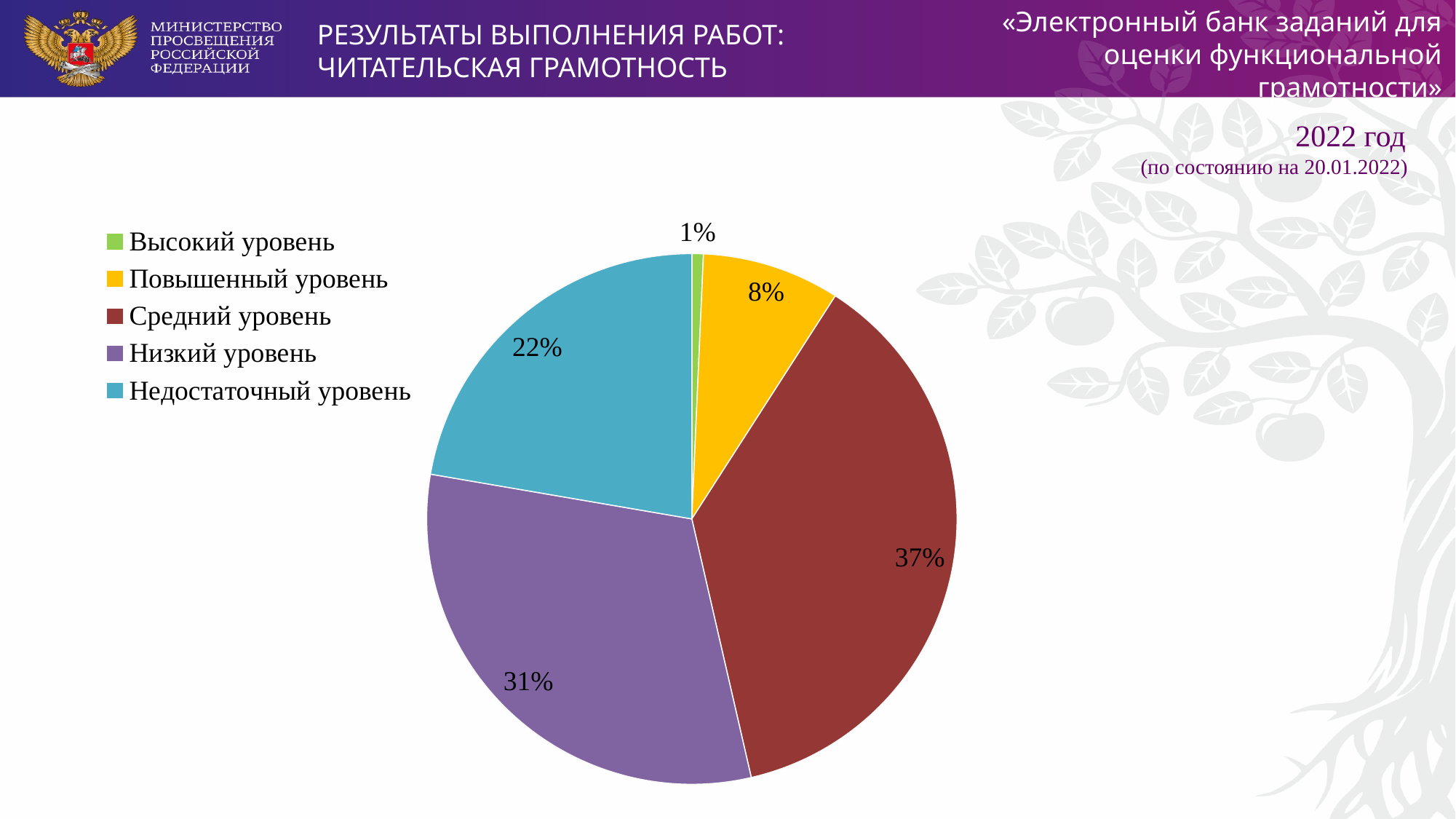
What share of the pie does Высокий уровень have? 1% What is the difference in percentage points between Средний уровень and Низкий уровень? 6 How many categories does the legend list? 5 What share of the pie does Низкий уровень have? 31% Which level has the largest slice of the pie? Средний уровень What share of the pie does Средний уровень have? 37% Which is larger: the share for Недостаточный уровень or the share for Повышенный уровень? Недостаточный уровень What kind of chart is shown on the slide? pie chart What colour is the slice for Низкий уровень? purple Which level has the smallest slice of the pie? Высокий уровень